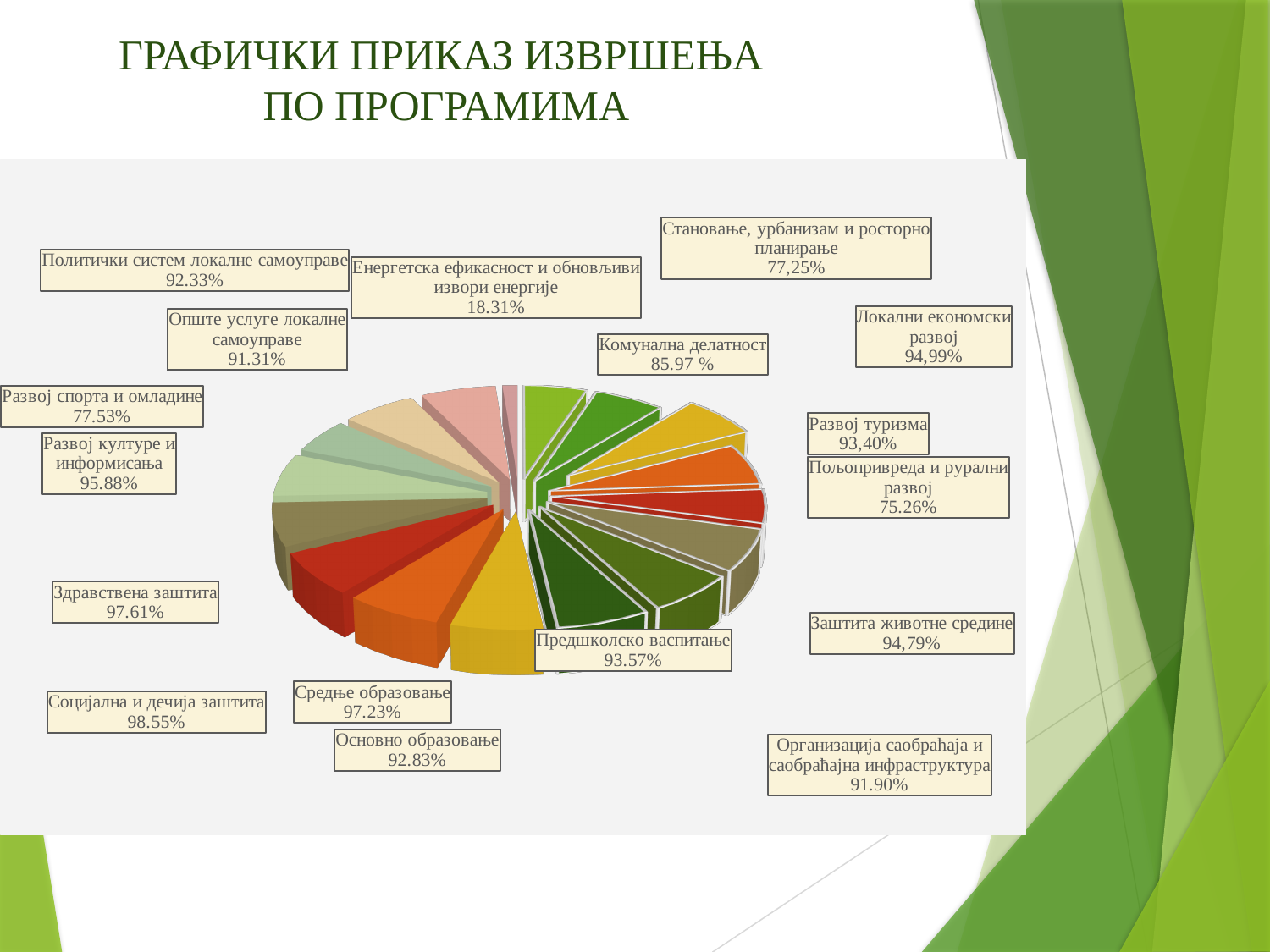
What is the difference between the values for Здравствена заштита and Средње образовање? 0.38% What kind of chart is shown on the slide? Pie chart Which program has the lowest value shown? Енергетска ефикасност и обновљиви извори енергије What is the value shown for Комунална делатност? 85.97 % What is the value shown for Енергетска ефикасност и обновљиви извори енергије? 18.31% Which program has the highest value shown? Социјална и дечија заштита What is the value shown for Предшколско васпитање? 93.57% Which has a larger value, Развој спорта и омладине or Пољопривреда и рурални развој? Развој спорта и омладине What is the value shown for Социјална и дечија заштита? 98.55% What is the title of the slide? ГРАФИЧКИ ПРИКАЗ ИЗВРШЕЊА ПО ПРОГРАМИМА What is the value shown for Локални економски развој? 94,99% How many programs are labeled on the chart? 17